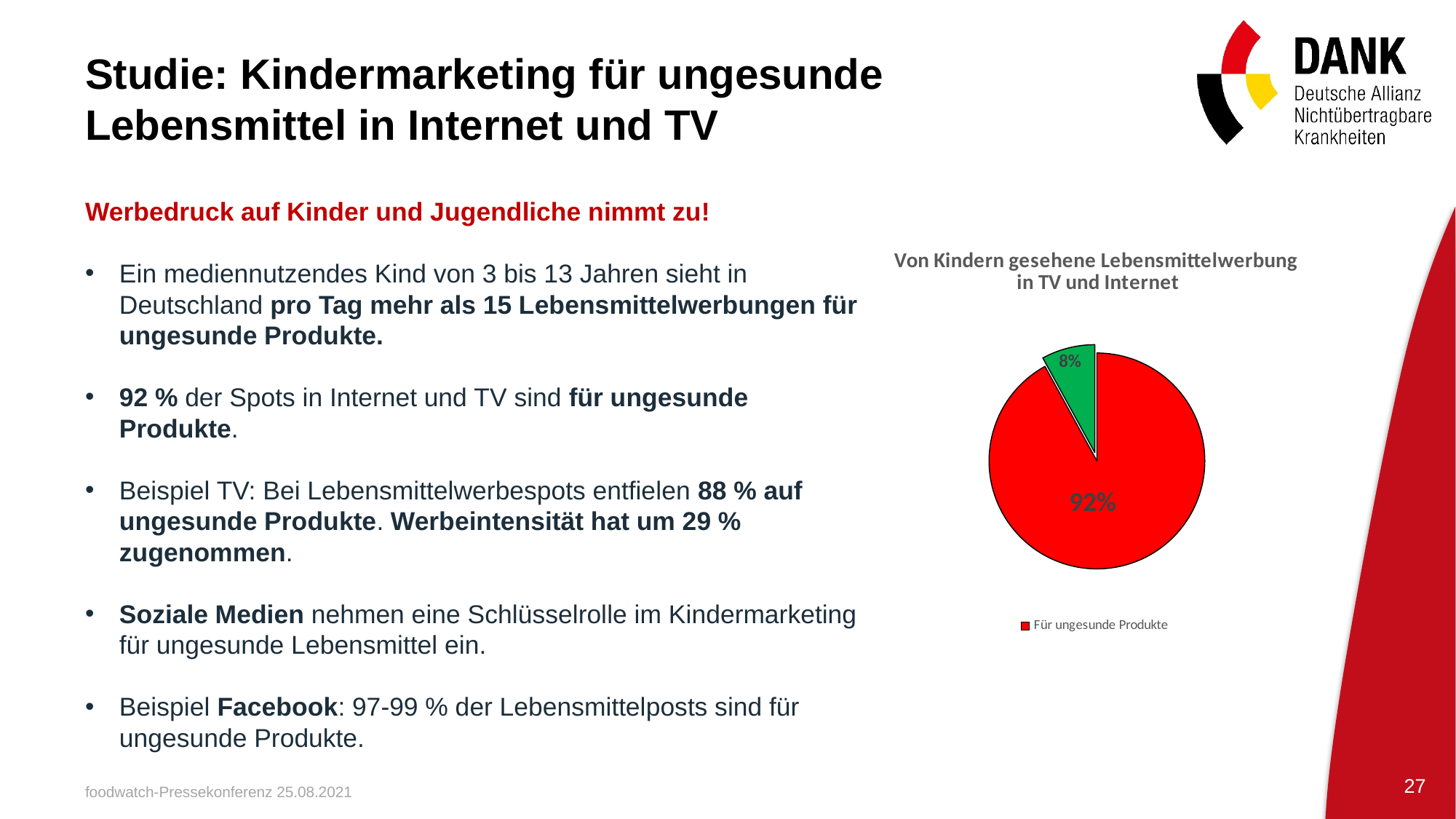
What is the title of the chart? Von Kindern gesehene Lebensmittelwerbung in TV und Internet What share of the pie is labelled "Für ungesunde Produkte"? 92% How many slices does the pie chart have? 2 Is the red slice larger or smaller than the green slice? larger Which slice of the pie chart is the largest? Für ungesunde Produkte (92%) What kind of chart is shown on the slide? pie chart What percentage is shown on the red slice of the pie chart? 92% How many entries does the chart legend list? 1 What is the difference in percentage points between the red slice and the green slice? 84 Is the share for "Für ungesunde Produkte" greater or less than 50%? greater What percentage is shown on the green slice of the pie chart? 8% Which slice of the pie chart is the smallest? the green slice (8%)